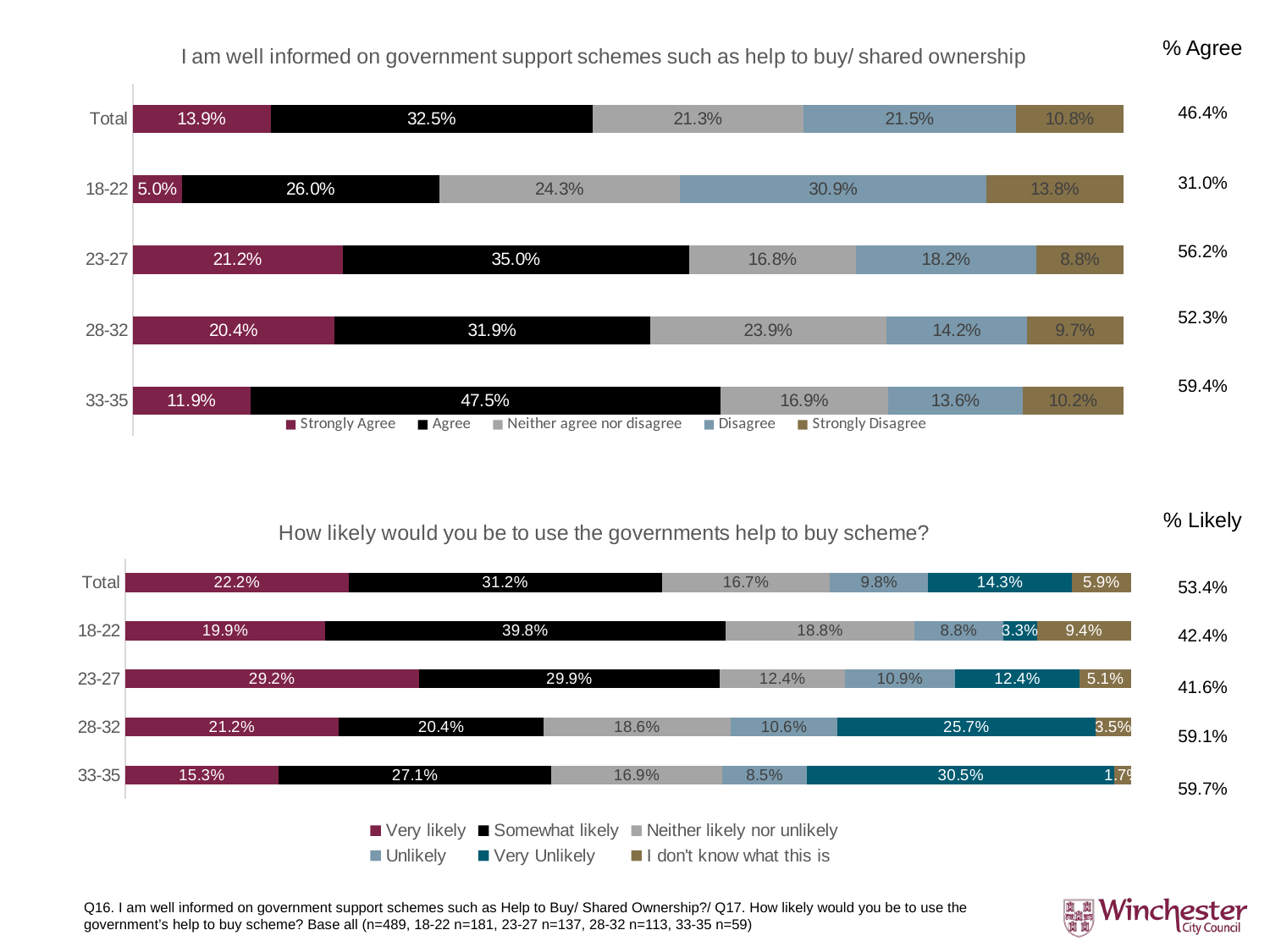
In the bottom chart, which age group has the lowest "Very likely" percentage? 33-35 In the top chart ("I am well informed on government support schemes..."), what percentage of the 33-35 age group answered "Agree"? 47.5% In the bottom chart, what percentage of the 18-22 age group answered "I don't know what this is"? 9.4% What type of chart is the top chart? Stacked bar chart In the top chart, what is the "% Agree" figure shown for the 23-27 age group? 56.2% How many age-group categories (including Total) are shown in the top chart? 5 How many series does the legend of the bottom chart list? 6 In the top chart, how many percentage points higher is the "Disagree" share for 18-22 than for Total? 9.4 percentage points In the bottom chart, which has the larger "Somewhat likely" share: 18-22 or 23-27? 18-22 In the bottom chart, what is the "% Likely" figure shown for the Total row? 53.4% In the top chart, which age group has the highest "Agree" percentage? 33-35 In the bottom chart ("How likely would you be to use the governments help to buy scheme?"), what percentage of the 28-32 age group answered "Very Unlikely"? 25.7%